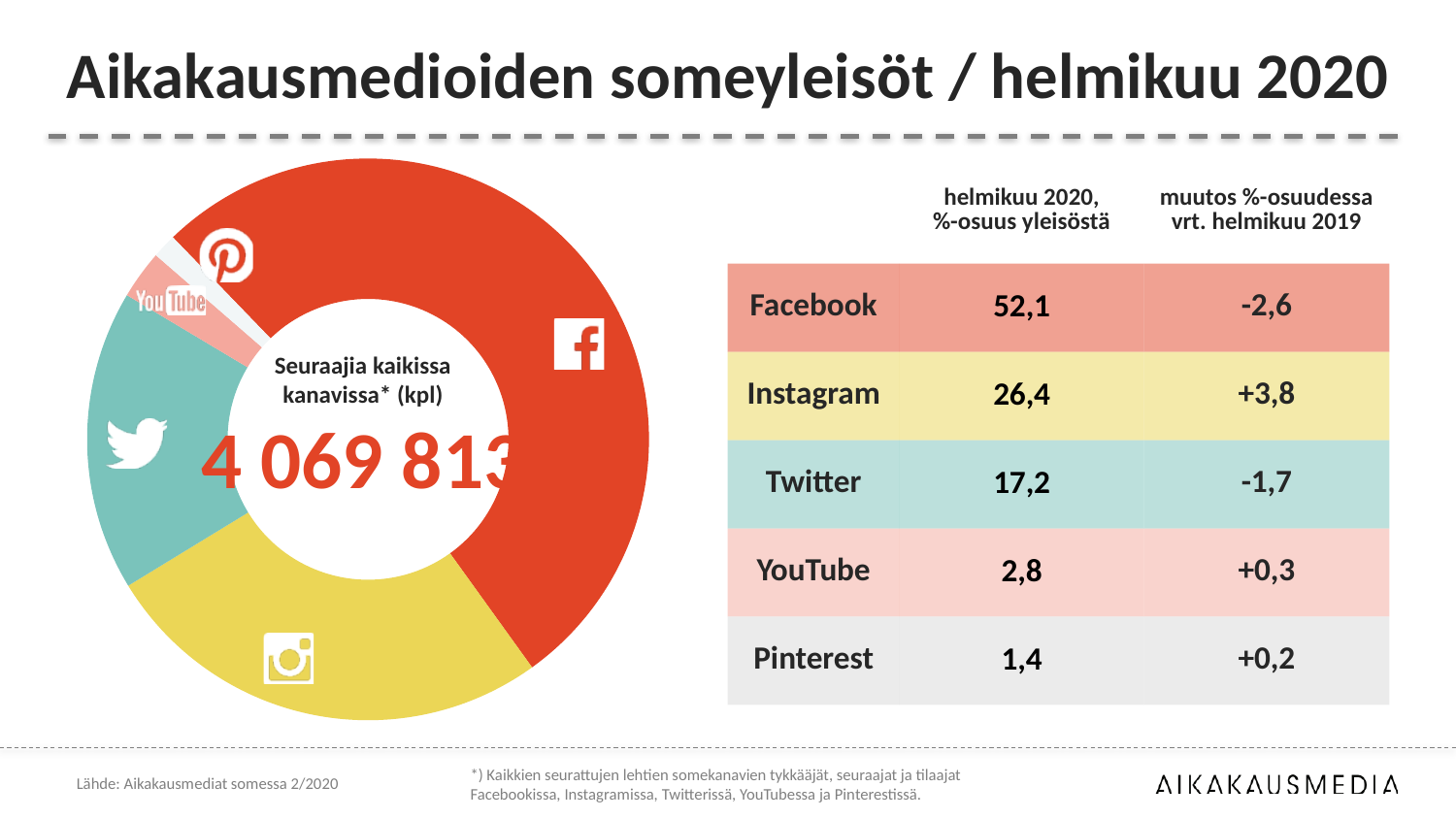
Which channel has the largest slice of the pie chart? Facebook What is Facebook's share of the audience in February 2020 according to the table? 52,1 What is the difference between Facebook's and Instagram's share of the audience in February 2020? 25,7 What kind of chart is shown on the left of the slide? doughnut chart What total number of followers across all channels is shown in the centre of the pie chart? 4 069 813 What is the title of the slide? Aikakausmedioiden someyleisöt / helmikuu 2020 How many social media channels are shown as slices in the pie chart? 5 What is Twitter's share of the audience in February 2020? 17,2 What is the change in Instagram's share compared with February 2019? +3,8 Which channel has the smallest slice of the pie chart? Pinterest Which channel's share decreased the most compared with February 2019? Facebook Which has a larger share of the audience, Twitter or Instagram? Instagram